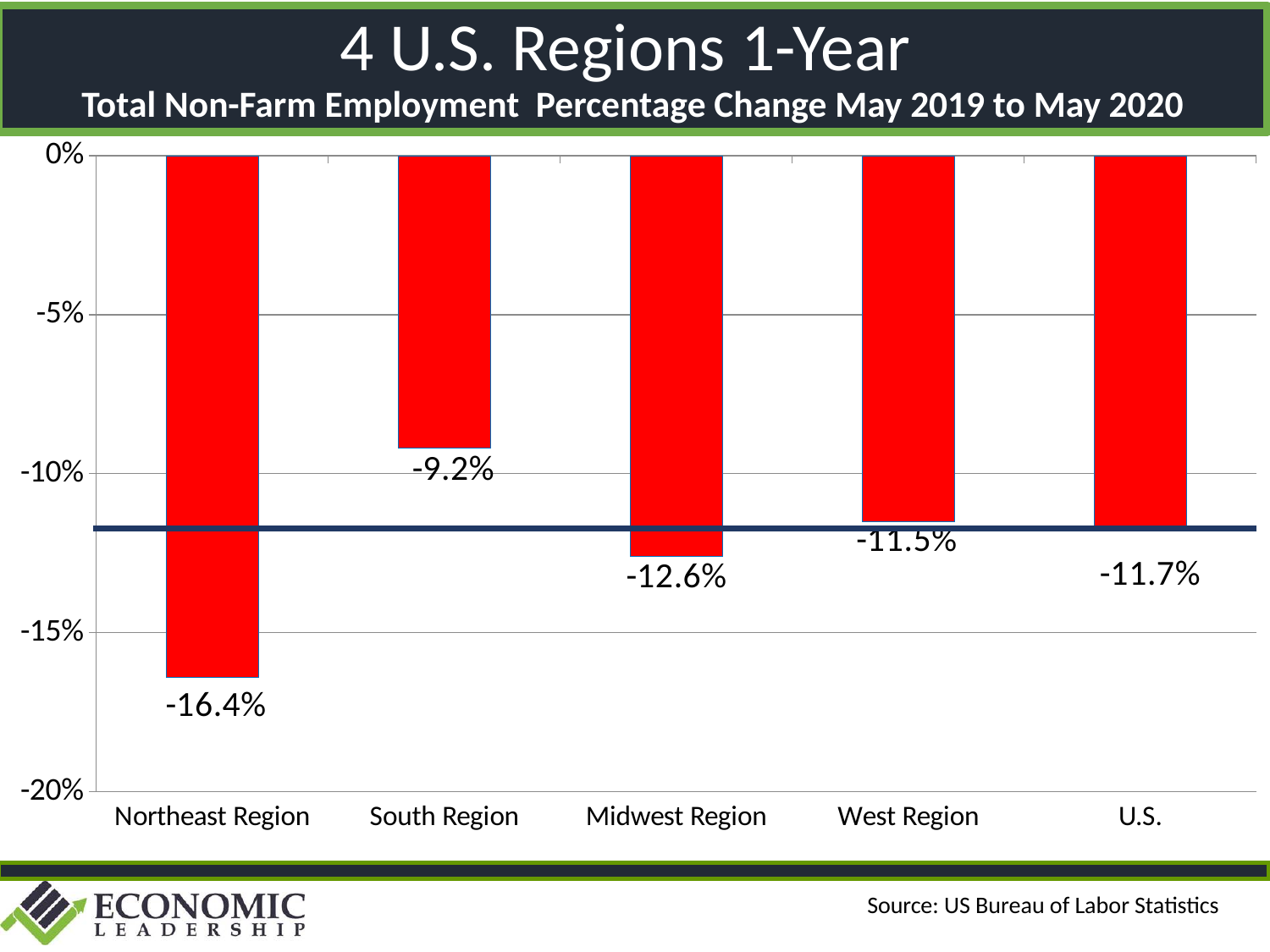
What is the value for the U.S.? -11.7% What is the value for the South Region? -9.2% What is the value for the West Region? -11.5% What source is cited at the bottom of the slide? US Bureau of Labor Statistics What kind of chart is shown on the slide? Bar chart How many categories are shown on the x axis? 5 What is the difference between the Northeast Region value and the South Region value? 7.2 percentage points What is the value for the Northeast Region? -16.4% Which category has the lowest value (the largest percentage decline)? Northeast Region Which category has the highest value (the smallest percentage decline)? South Region Which has the larger decline, the Midwest Region or the West Region? Midwest Region What is the value for the Midwest Region? -12.6%